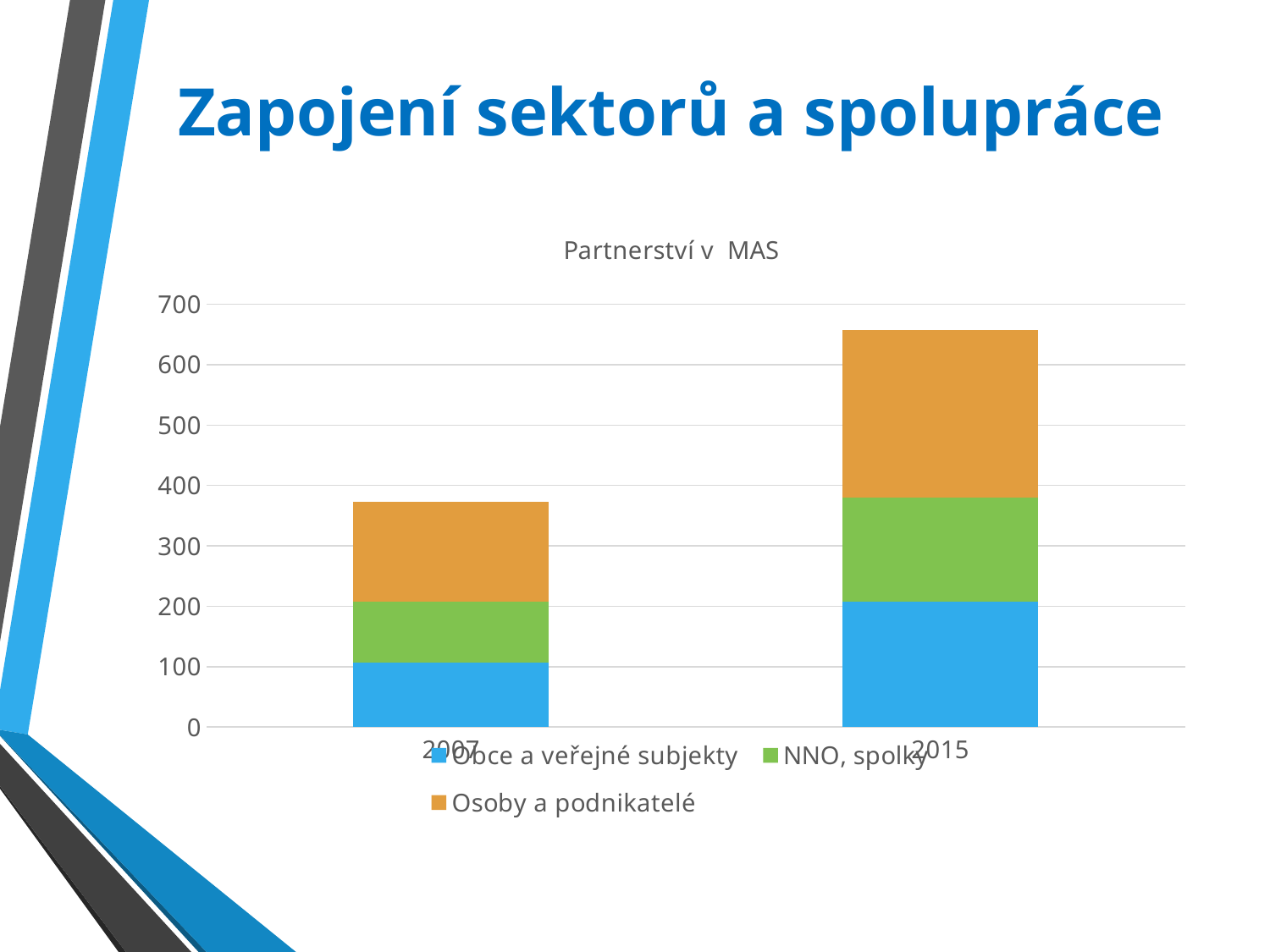
Is the total of the stacked bar for 2007 greater or less than 400? less Which category has the lowest total? 2007 Is the total of the stacked bar for 2007 greater or less than 300? greater Which year has the taller stacked bar, 2007 or 2015? 2015 Which series is shown in orange? Osoby a podnikatelé What type of chart is shown on the slide? stacked bar chart Which category has the highest total? 2015 Do the totals rise or fall from 2007 to 2015? rise Is the total of the stacked bar for 2015 greater or less than 600? greater How many categories are shown on the x axis? 2 How many series does the legend list? 3 What is the title of the chart? Partnerství v MAS